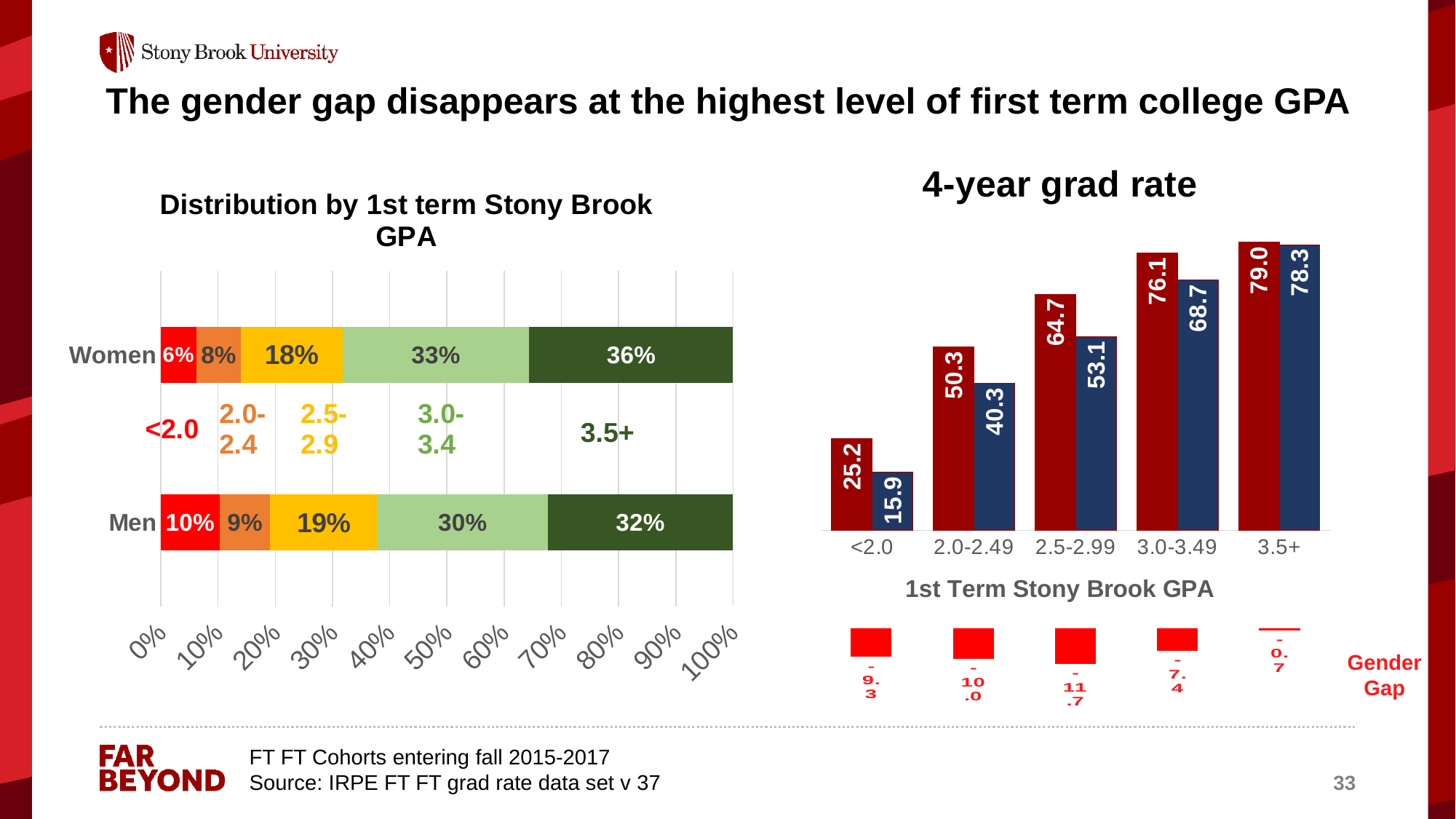
In the '4-year grad rate' chart, how many GPA groups are shown on the x axis? 5 In the '4-year grad rate' chart, which GPA group has the highest red bar? 3.5+ In the 'Distribution by 1st term Stony Brook GPA' chart, what percentage of women have a GPA of 3.5+? 36% In the 'Distribution by 1st term Stony Brook GPA' chart, what type of chart is used? Stacked bar chart In the 'Distribution by 1st term Stony Brook GPA' chart, what percentage of men have a GPA below 2.0? 10% In the 'Distribution by 1st term Stony Brook GPA' chart, what is the difference between the women's and men's shares in the 3.0-3.4 band? 3% In the '4-year grad rate' chart, what is the difference between the red and blue bars for the 3.0-3.49 GPA group? 7.4 In the '4-year grad rate' chart, what is the value of the blue bar for the 2.5-2.99 GPA group? 53.1 In the '4-year grad rate' chart, what is the value of the red bar for the <2.0 GPA group? 25.2 In the '4-year grad rate' chart, do the blue bars rise or fall as GPA increases along the x axis? Rise In the 'Distribution by 1st term Stony Brook GPA' chart, how many GPA bands make up each bar? 5 In the 'Distribution by 1st term Stony Brook GPA' chart, which GPA band is the largest segment for men? 3.5+